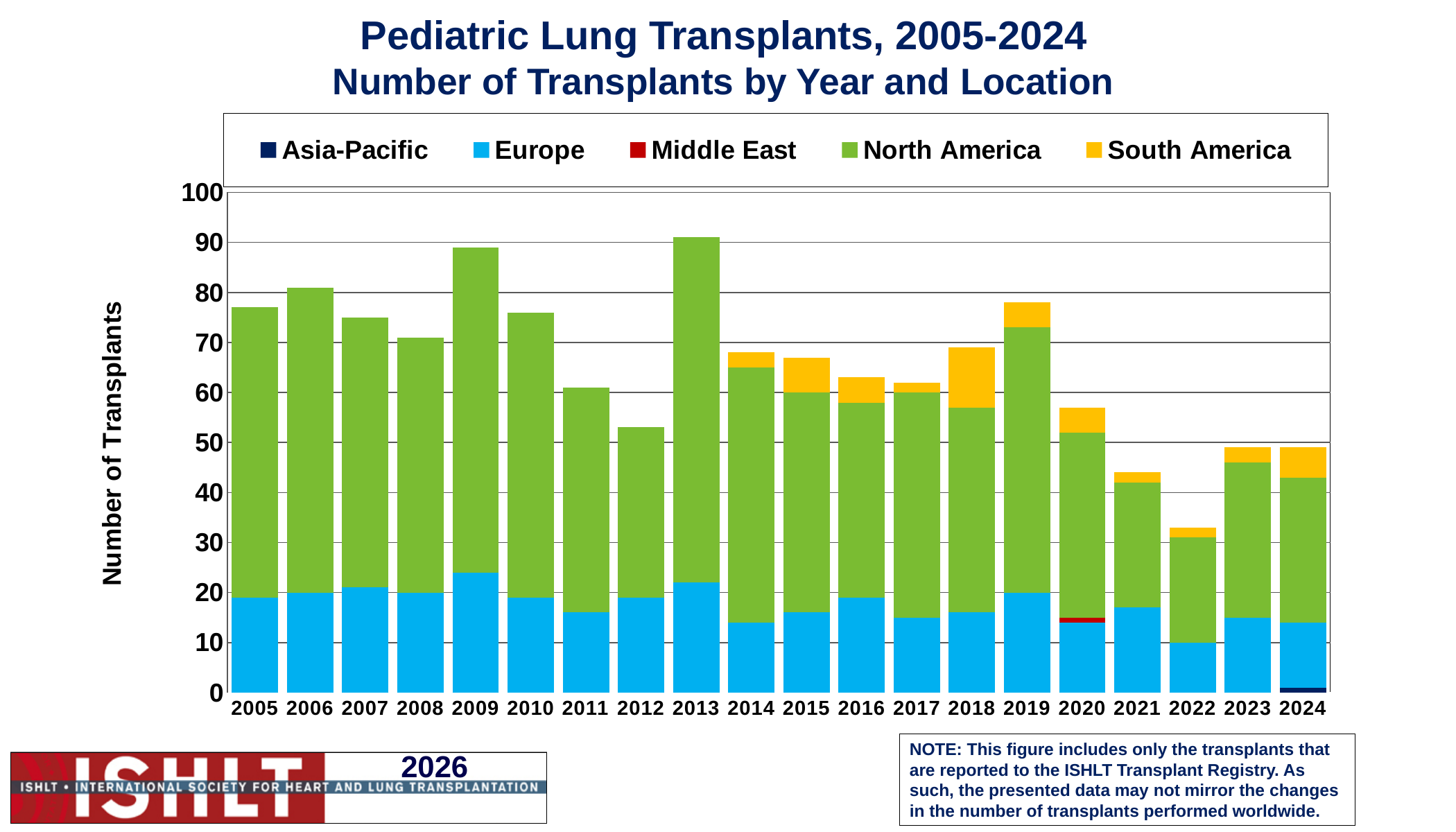
Is the Europe value in 2009 greater or less than 20? greater Which year has the larger total number of transplants, 2009 or 2010? 2009 Is the total number of transplants in 2005 greater or less than 70? greater What is the title of the y axis? Number of Transplants What kind of chart is shown on the slide? Stacked bar chart Which year has the lowest total number of transplants? 2022 How many series does the legend list? 5 Is the total number of transplants in 2022 greater or less than 40? less Which year has the larger total number of transplants, 2021 or 2023? 2023 Do the total numbers of transplants rise or fall from 2019 to 2022? fall How many years are shown along the x axis? 20